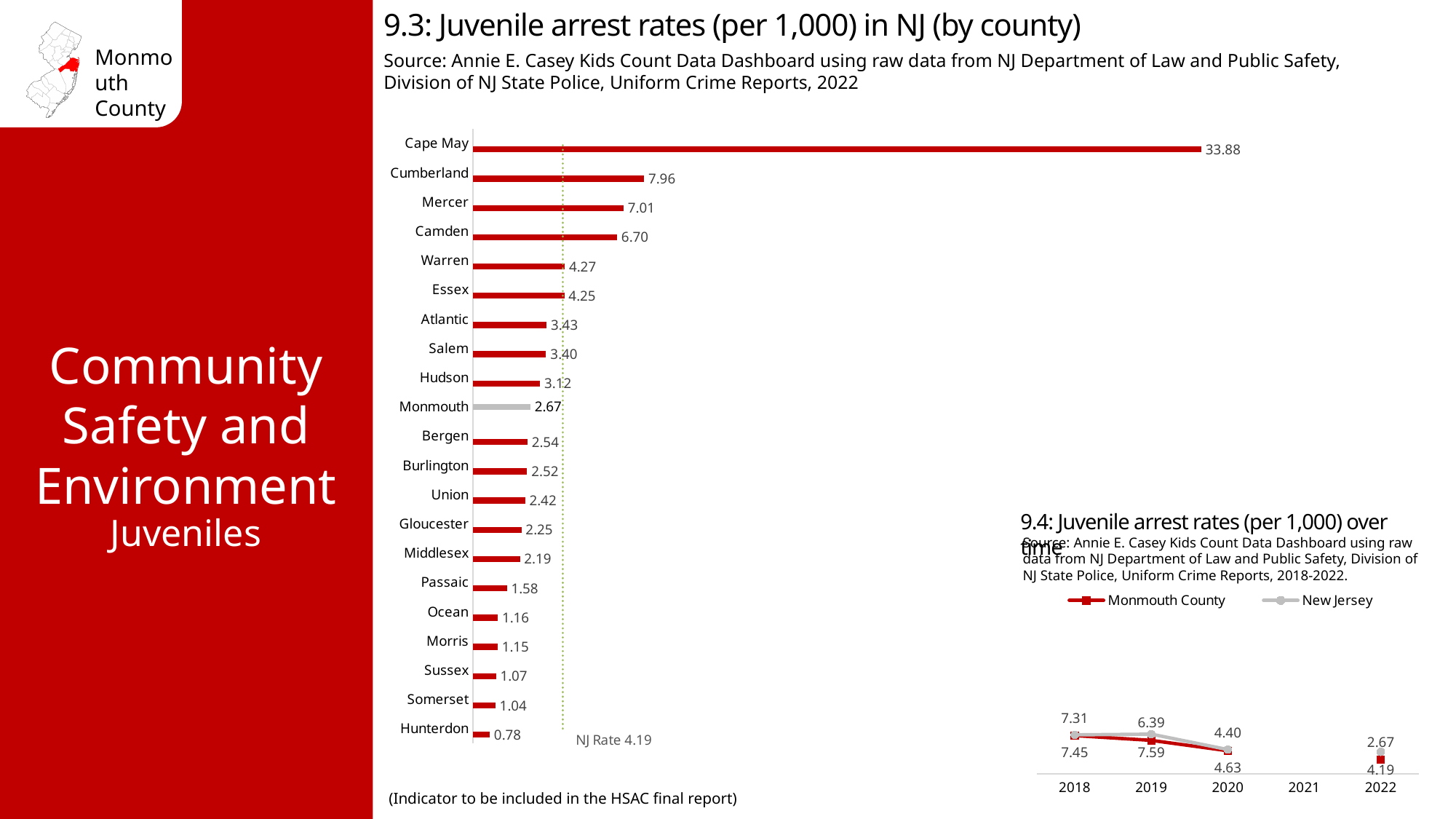
In chart 9.3, what is the juvenile arrest rate for Monmouth? 2.67 In chart 9.4, what is the New Jersey juvenile arrest rate in 2022? 4.19 In chart 9.3, what is the juvenile arrest rate for Cape May? 33.88 In chart 9.3, what is the difference between the rates for Cumberland and Mercer? 0.95 In chart 9.3, which county has the highest juvenile arrest rate? Cape May What kind of chart is chart 9.3? Bar chart In chart 9.4, how many series does the legend list? 2 In chart 9.3, how many counties are shown? 21 In chart 9.3, which has a higher juvenile arrest rate, Camden or Atlantic? Camden In chart 9.3, which county has the lowest juvenile arrest rate? Hunterdon In chart 9.4, what is the Monmouth County juvenile arrest rate in 2022? 2.67 In chart 9.3, what NJ rate is marked by the dotted reference line? 4.19